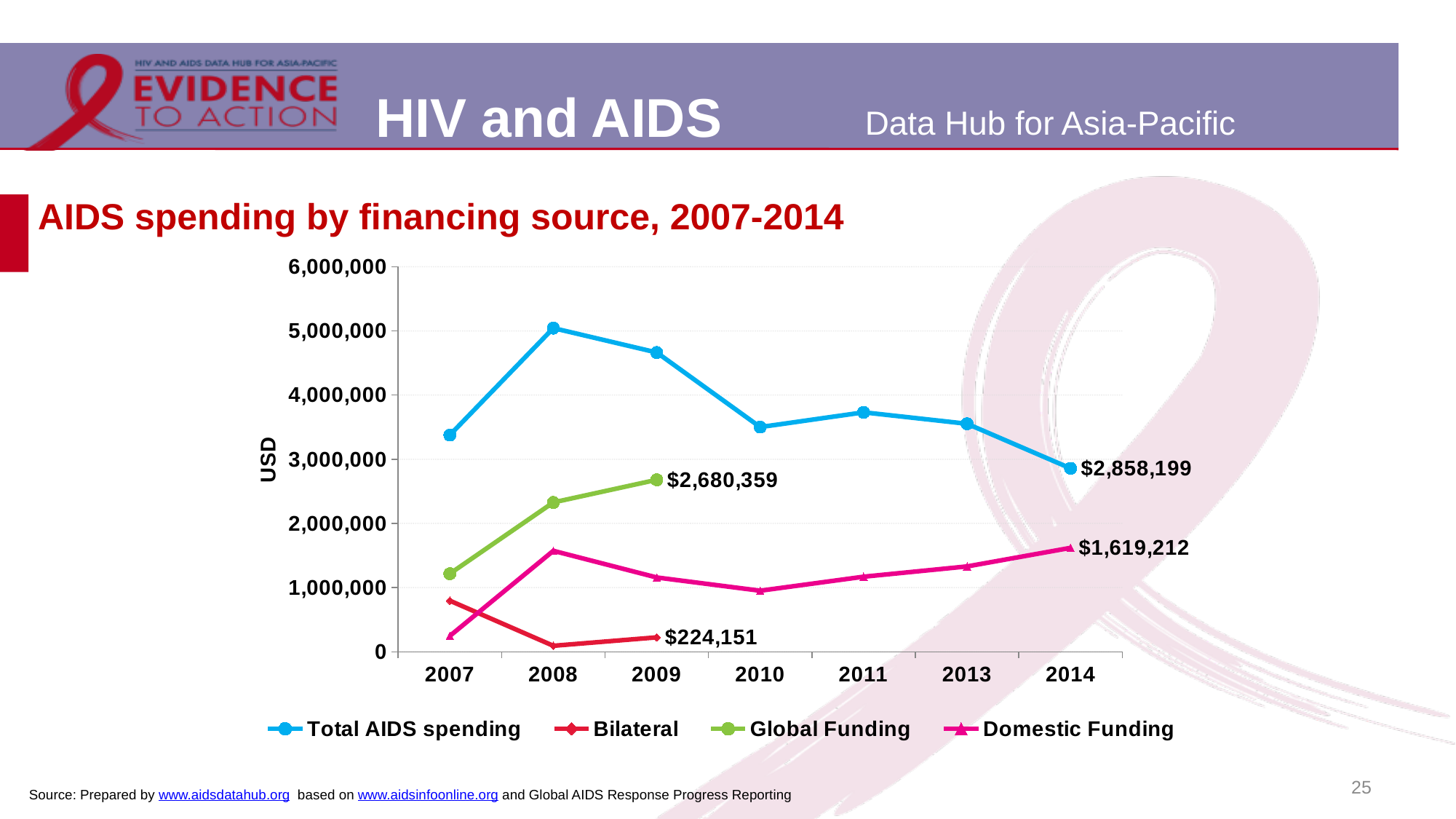
What is the value of Domestic Funding in 2014? $1,619,212 In which year is Total AIDS spending highest? 2008 What is the value of Total AIDS spending in 2014? $2,858,199 What is the value of Bilateral funding in 2009? $224,151 What is the difference between Total AIDS spending in 2014 and Domestic Funding in 2014? $1,238,987 What is the value of Global Funding in 2009? $2,680,359 Which is larger in 2009, Global Funding or Domestic Funding? Global Funding How many years are shown on the x axis? 7 What type of chart is shown on the slide? line chart How many series does the legend list? 4 What is the title of the chart? AIDS spending by financing source, 2007-2014